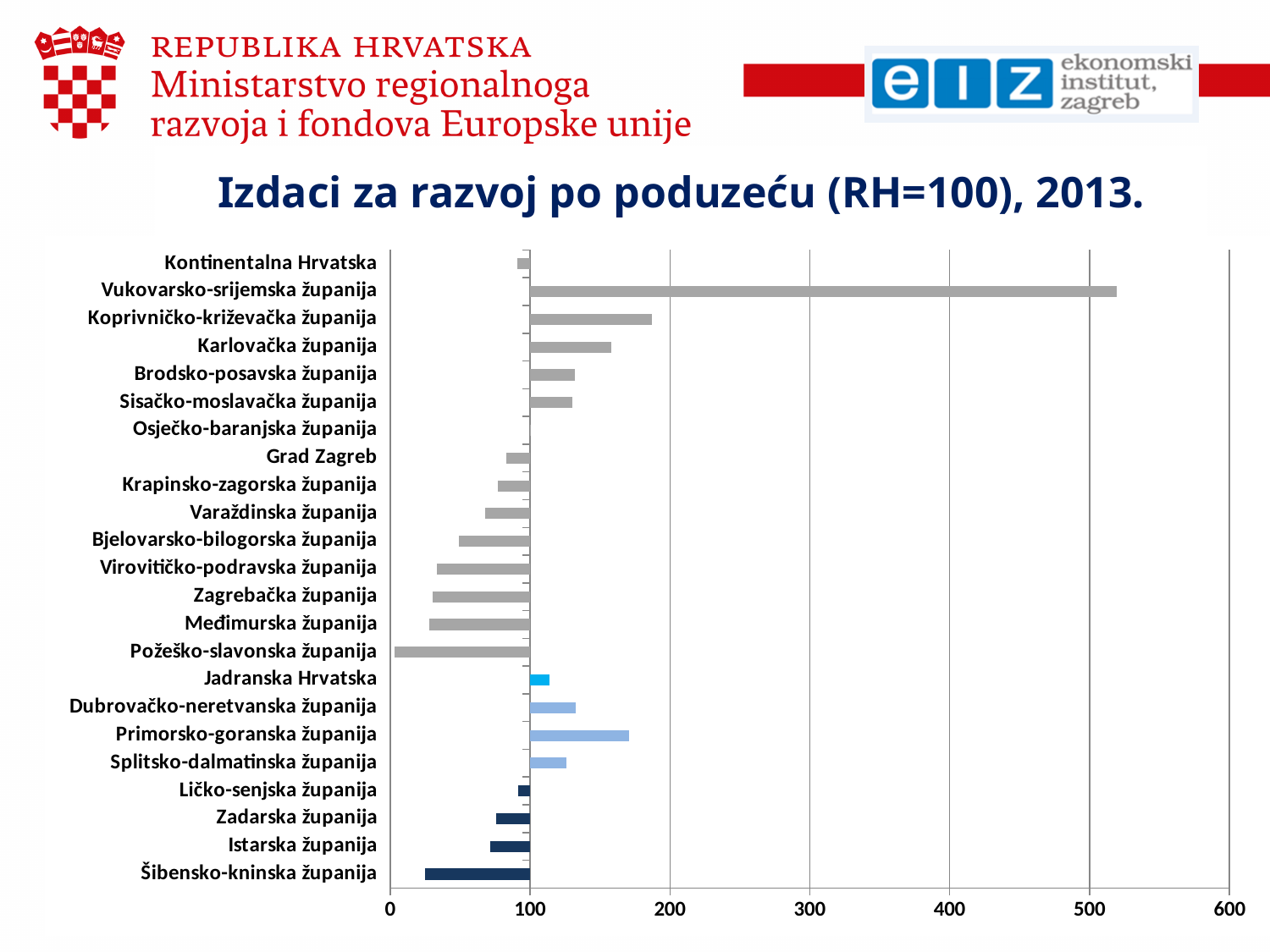
Which category has the lowest value? Požeško-slavonska županija What is the title of the chart? Izdaci za razvoj po poduzeću (RH=100), 2013. Is the value for Primorsko-goranska županija greater or less than 100? greater Is the value for Koprivničko-križevačka županija greater or less than 200? less Which is larger, the value for Vukovarsko-srijemska županija or Koprivničko-križevačka županija? Vukovarsko-srijemska županija How many categories are plotted on the chart? 23 Which category has the highest value? Vukovarsko-srijemska županija What is the highest value shown on the horizontal axis? 600 Is the value for Vukovarsko-srijemska županija greater or less than 500? greater What kind of chart is shown on the slide? bar chart Which is larger, the value for Primorsko-goranska županija or Splitsko-dalmatinska županija? Primorsko-goranska županija